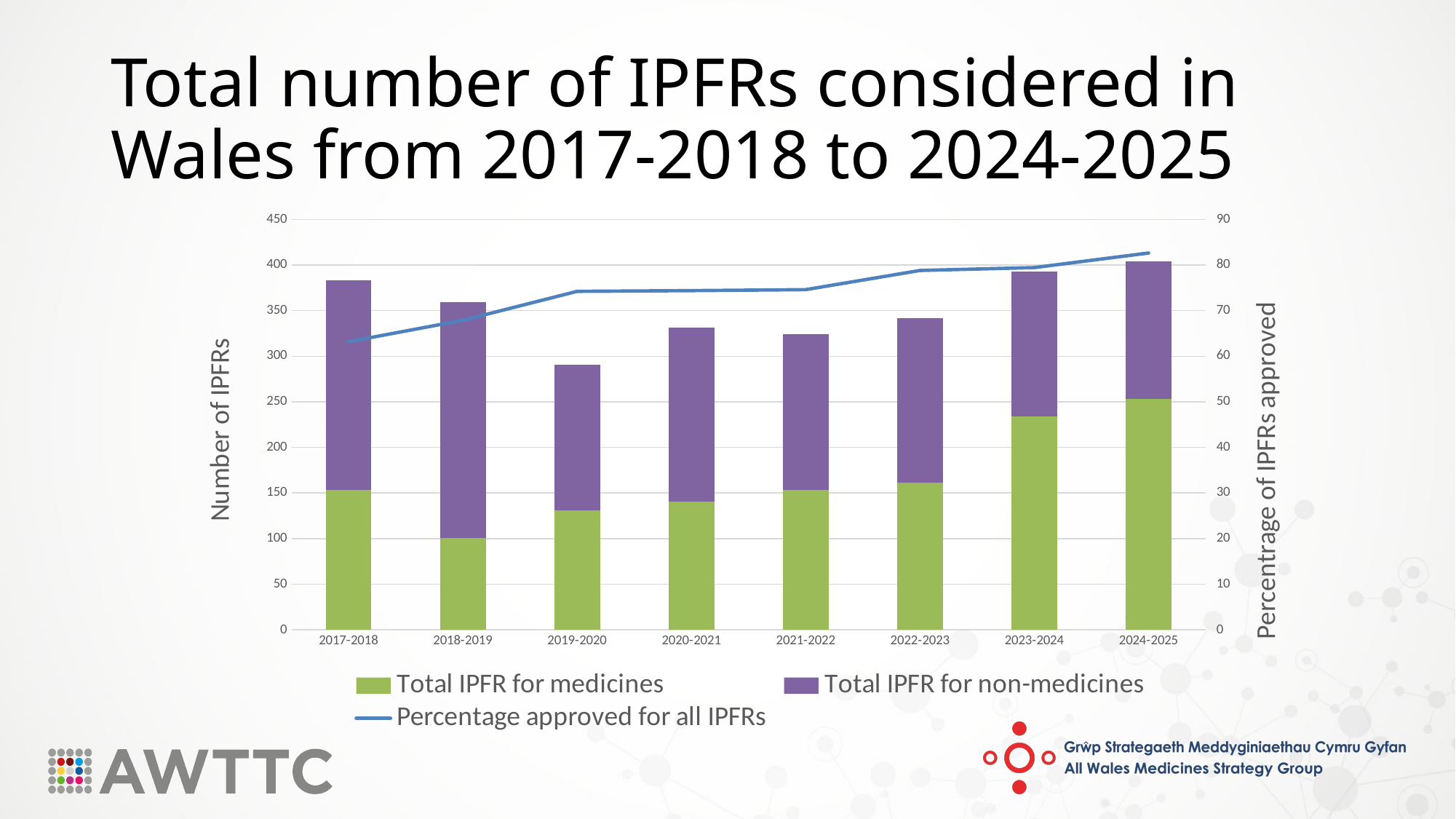
Which year has the highest number of IPFRs for medicines? 2024-2025 Does the percentage approved for all IPFRs generally rise or fall from 2017-2018 to 2024-2025? rise Is the number of IPFRs for medicines in 2023-2024 greater or less than 200? greater Which year has the lowest total number of IPFRs? 2019-2020 How many series does the legend list? 3 What kind of chart is shown on the slide? A stacked bar chart with a line Is the total number of IPFRs in 2019-2020 greater or less than 300? less Is the percentage approved for all IPFRs in 2017-2018 greater or less than 70? less Which year has the larger total number of IPFRs, 2017-2018 or 2018-2019? 2017-2018 How many year categories are shown on the x axis? 8 What is the title of the right-hand vertical axis? Percentage of IPFRs approved Which year has the lowest number of IPFRs for medicines? 2018-2019